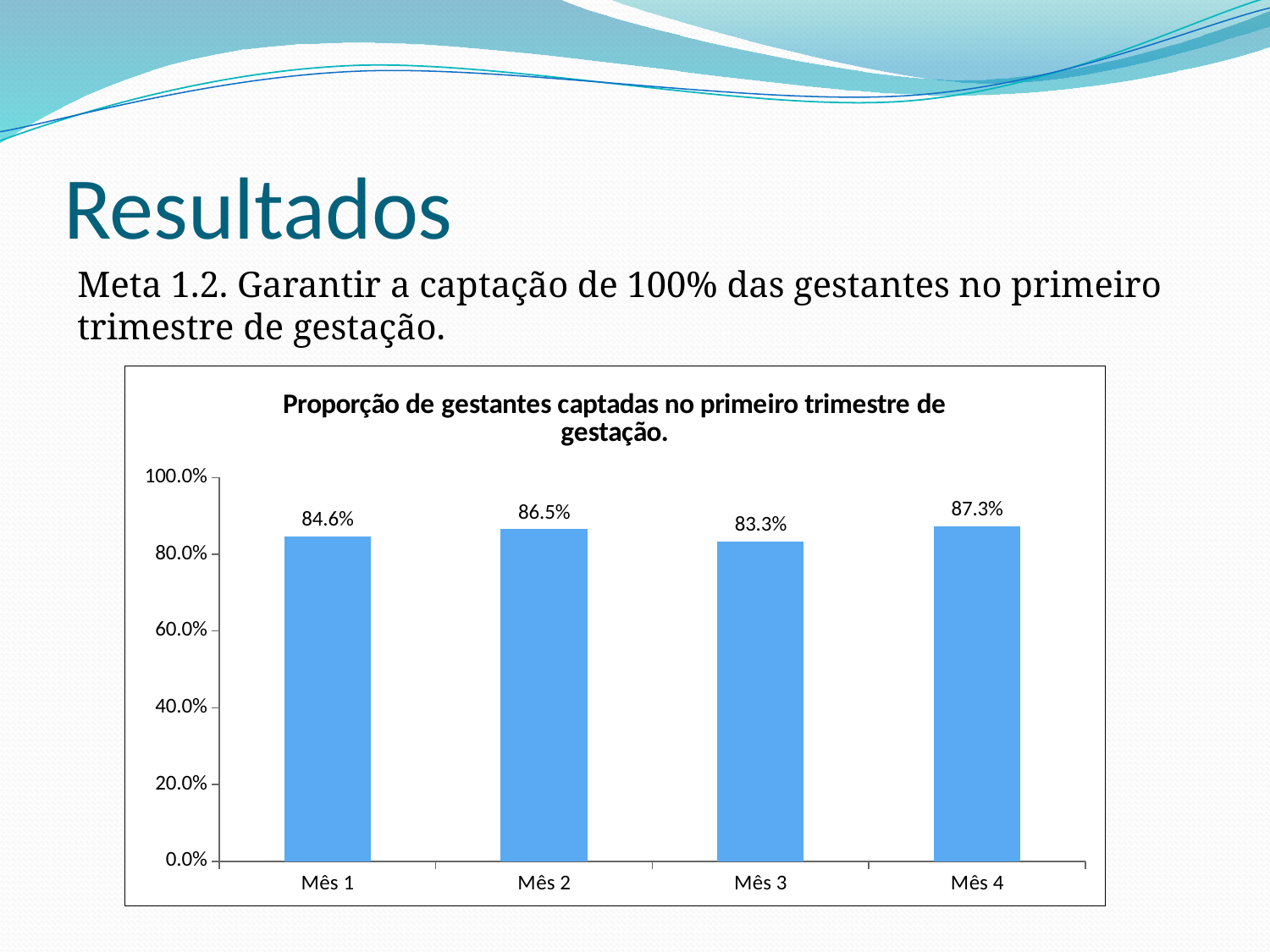
Which month has the lowest proportion? Mês 3 Is the value for Mês 3 greater or less than 80.0%? greater How many months are shown on the x axis? 4 What is the value for Mês 3? 83.3% What is the value for Mês 2? 86.5% What is the title of the chart? Proporção de gestantes captadas no primeiro trimestre de gestação. What is the value for Mês 1? 84.6% Which is larger, the value for Mês 2 or the value for Mês 1? Mês 2 What kind of chart is shown on the slide? bar chart What is the difference between the values for Mês 4 and Mês 3? 4.0% Which month has the highest proportion? Mês 4 What is the value for Mês 4? 87.3%